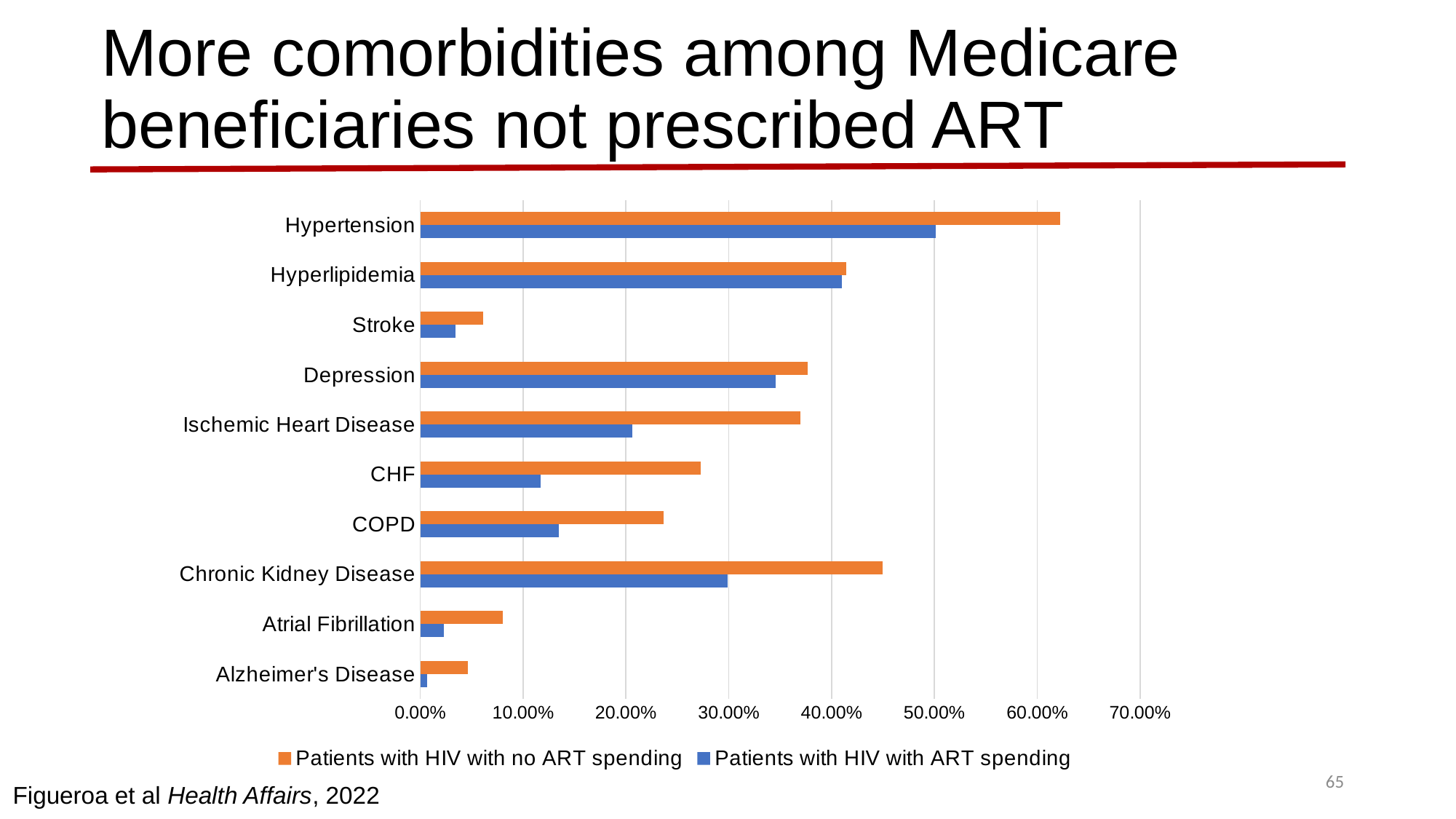
Is the value for Hypertension among Patients with HIV with no ART spending greater or less than 60.00%? greater For Ischemic Heart Disease, which series has the larger value: Patients with HIV with no ART spending or Patients with HIV with ART spending? Patients with HIV with no ART spending How many series does the legend list? 2 Is the value for Chronic Kidney Disease among Patients with HIV with no ART spending greater or less than 40.00%? greater What kind of chart is shown on the slide? Bar chart How many comorbidity categories are plotted on the chart? 10 Is the value for Depression among Patients with HIV with ART spending greater or less than 30.00%? greater Among Patients with HIV with no ART spending, which is larger: Chronic Kidney Disease or Depression? Chronic Kidney Disease Which comorbidity has the highest value for Patients with HIV with no ART spending? Hypertension Which colour represents Patients with HIV with no ART spending in the legend? Orange Which comorbidity has the lowest value for Patients with HIV with ART spending? Alzheimer's Disease